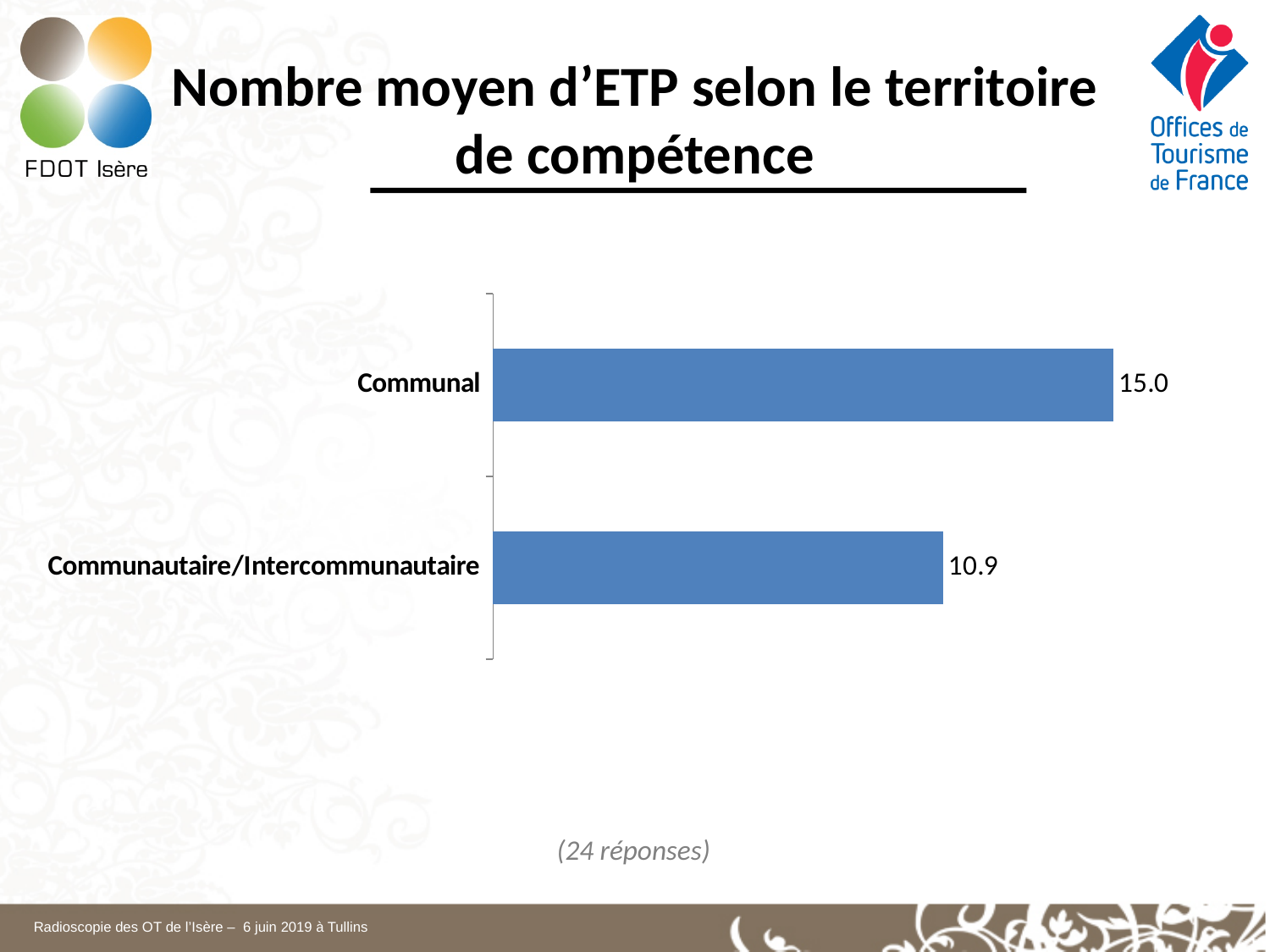
Which is larger, the value for Communal or the value for Communautaire/Intercommunautaire? Communal What is the value for Communal? 15.0 How many categories are shown in the chart? 2 How many responses does the note below the chart say the data is based on? 24 réponses What is the title of the slide? Nombre moyen d'ETP selon le territoire de compétence What kind of chart is shown on the slide? bar chart What is the value for Communautaire/Intercommunautaire? 10.9 What is the difference between the values for Communal and Communautaire/Intercommunautaire? 4.1 Which category has the lowest value? Communautaire/Intercommunautaire Which category has the highest value? Communal